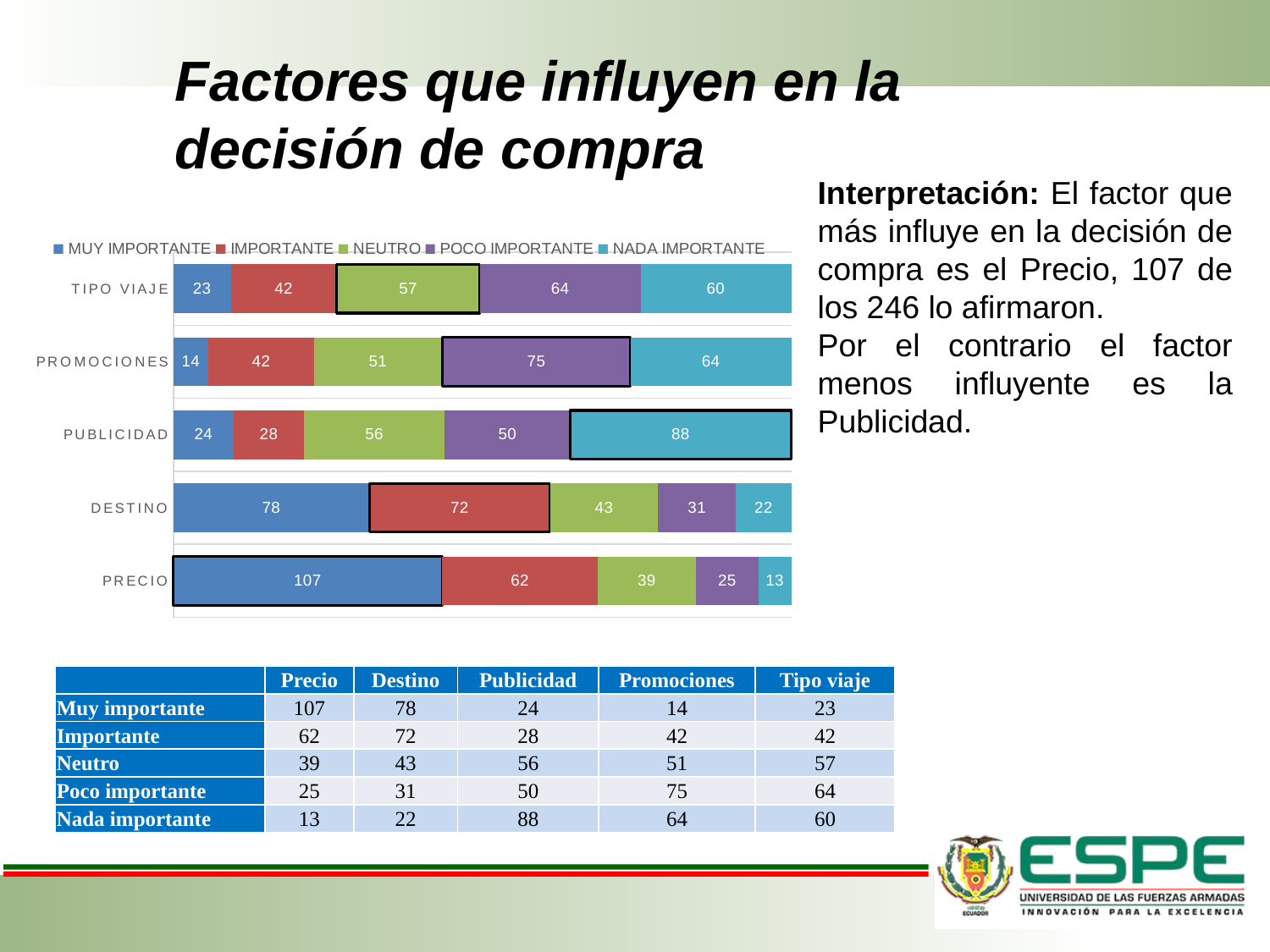
Which category has the lowest MUY IMPORTANTE value? PROMOCIONES What is the NADA IMPORTANTE value for PUBLICIDAD? 88 What type of chart is shown on the slide? Stacked bar chart Which is larger, the NEUTRO value for TIPO VIAJE or the NEUTRO value for PRECIO? TIPO VIAJE What is the total of the stacked bar for DESTINO? 246 Which series is shown in red in the chart legend? IMPORTANTE What is the POCO IMPORTANTE value for PROMOCIONES? 75 Which category has the highest MUY IMPORTANTE value? PRECIO What is the MUY IMPORTANTE value for PRECIO? 107 How many series does the chart legend list? 5 How many categories are plotted on the chart? 5 What is the difference between the IMPORTANTE values for DESTINO and PUBLICIDAD? 44